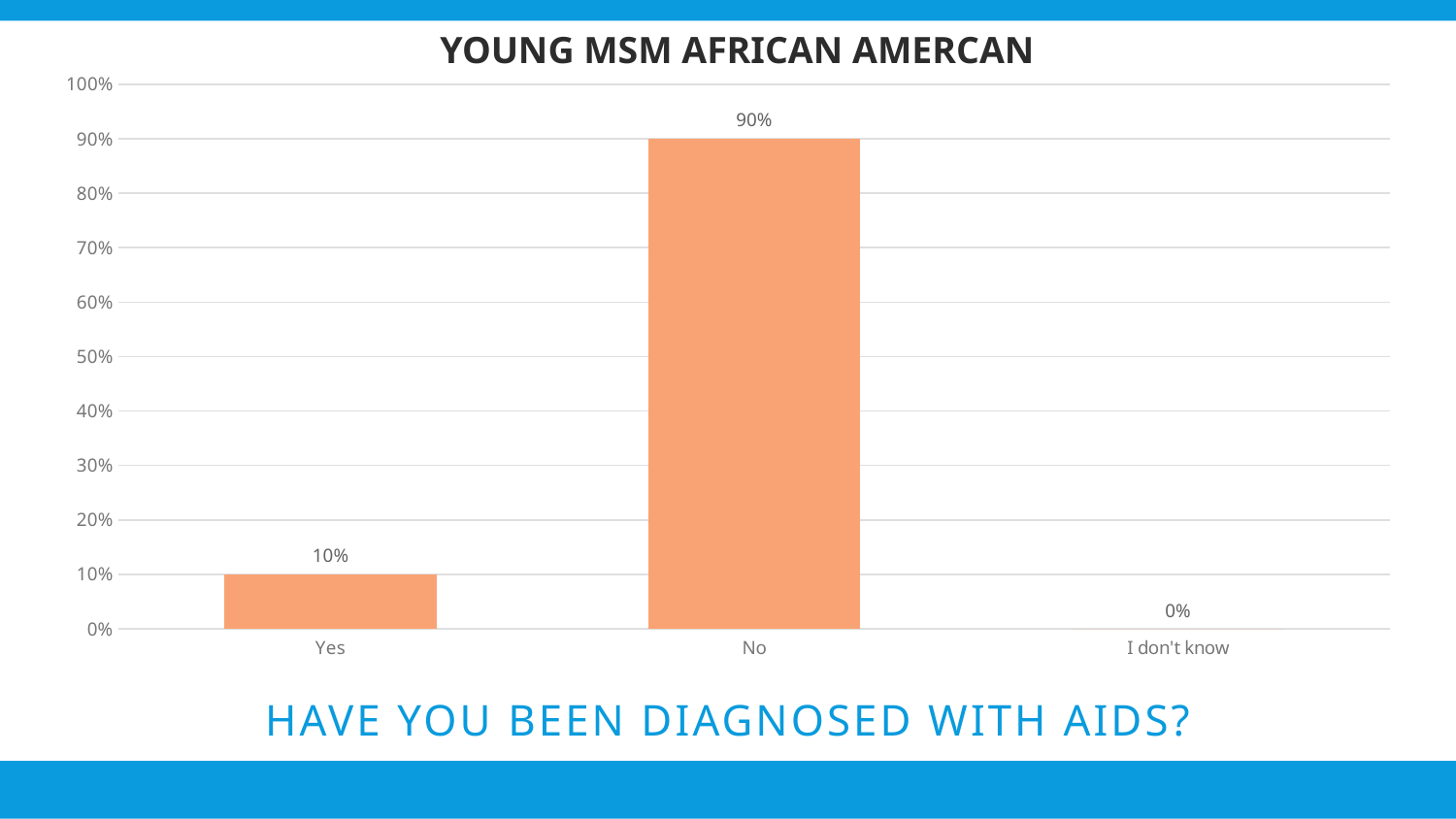
What question is written below the chart? HAVE YOU BEEN DIAGNOSED WITH AIDS? Which category has the highest value? No What is the title of the chart? YOUNG MSM AFRICAN AMERCAN Which category has the lowest value? I don't know What is the value for "No"? 90% Which is larger, the value for "Yes" or the value for "No"? No Is the value for "No" greater or less than 50%? greater What is the difference between the values for "No" and "Yes"? 80% What is the value for "I don't know"? 0% How many categories are shown on the x axis? 3 What kind of chart is shown on the slide? Bar chart What is the value for "Yes"? 10%